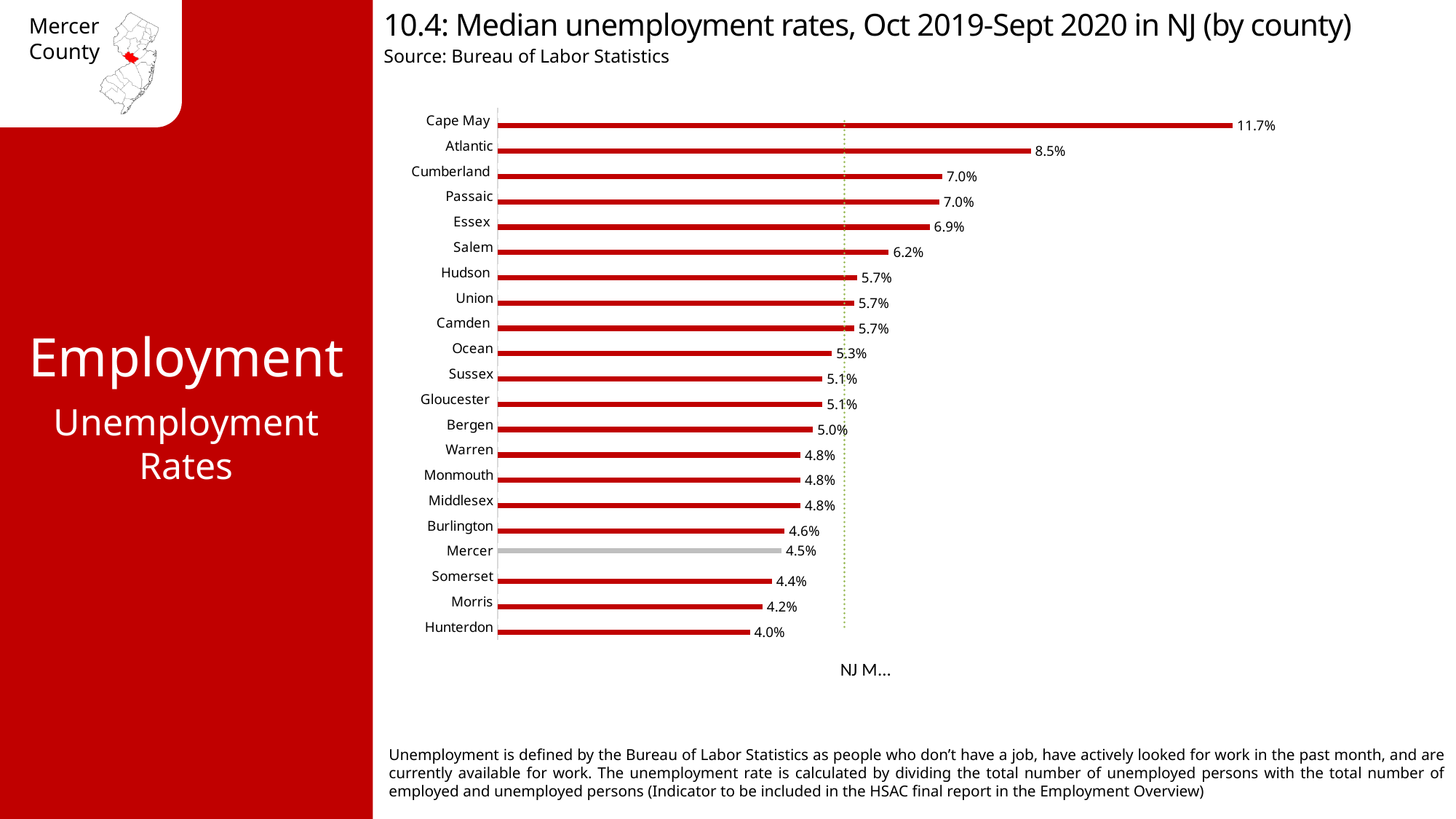
Which county's bar is shown in grey rather than red? Mercer Which county has the highest median unemployment rate? Cape May What is the median unemployment rate for Cape May? 11.7% What is the median unemployment rate for Essex? 6.9% Which county has a higher median unemployment rate, Salem or Hudson? Salem What is the difference between the median unemployment rates of Mercer and Hunterdon? 0.5% How many counties are shown in the chart? 21 Which county has a higher median unemployment rate, Mercer or Burlington? Burlington What kind of chart is used to show the median unemployment rates? Bar chart What is the difference between the median unemployment rates of Cape May and Atlantic? 3.2% Which county has the lowest median unemployment rate? Hunterdon What is the median unemployment rate for Mercer County? 4.5%